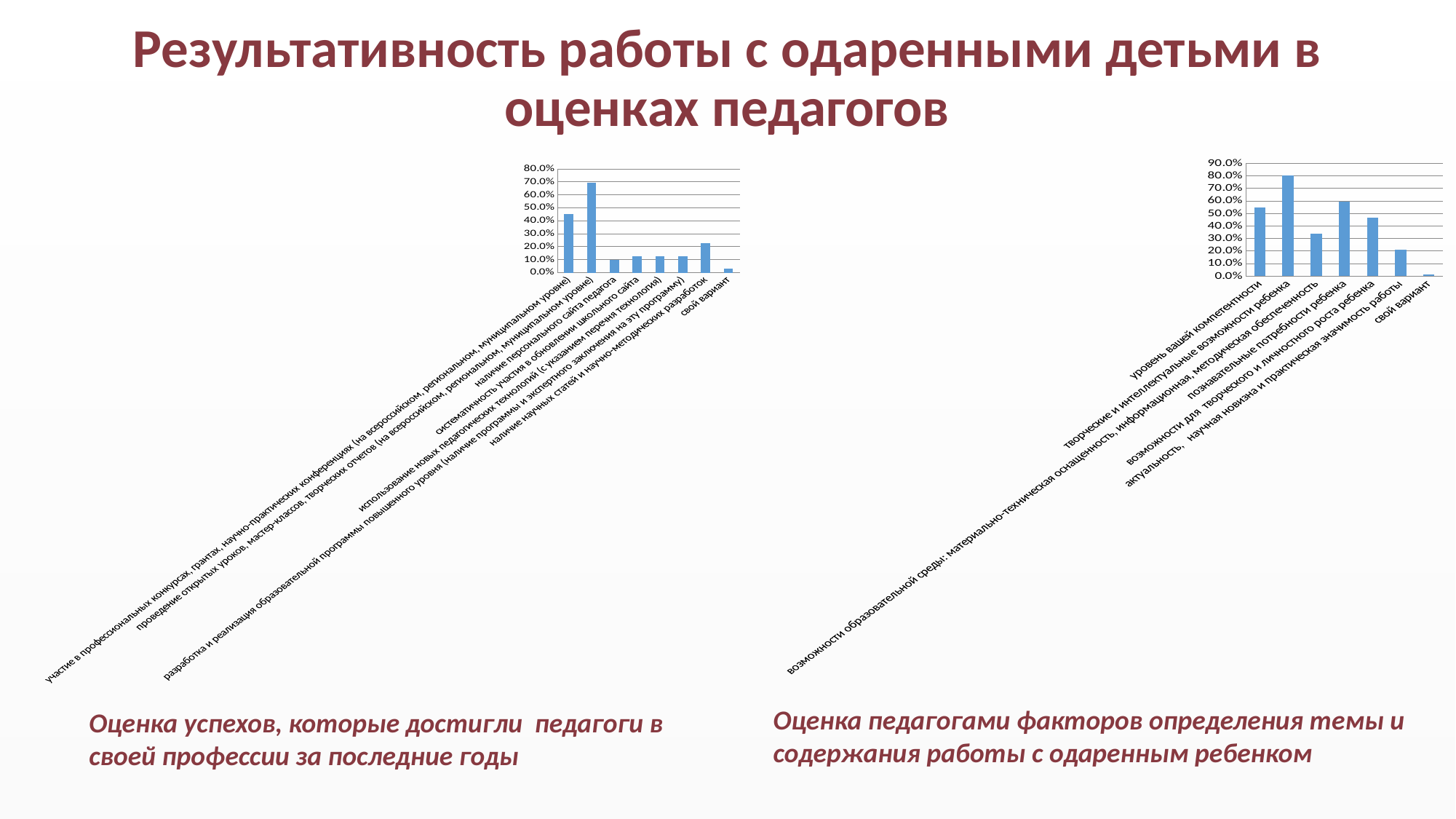
What kind of chart is the left chart on the slide? bar chart In the right chart, which is larger: the value for 'возможности для творческого и личностного роста ребенка' or the value for 'актуальность, научная новизна и практическая значимость работы'? возможности для творческого и личностного роста ребенка In the right chart, which category has the highest value? творческие и интеллектуальные возможности ребенка In the left chart, which category has the highest value? проведение открытых уроков, мастер-классов, творческих отчетов (на всероссийском, региональном, муниципальном уровне) In the left chart, which category has the lowest value? свой вариант In the right chart, is the value for 'познавательные потребности ребенка' greater or less than 40.0%? greater In the left chart, is the value for 'наличие научных статей и научно-методических разработок' greater or less than 30.0%? less How many categories does the left chart (Оценка успехов, которые достигли педагоги в своей профессии) show? 8 In the right chart, is the value for 'уровень вашей компетентности' greater or less than 50.0%? greater What is the highest tick value shown on the y axis of the right chart? 90.0% In the right chart, which category has the lowest value? свой вариант How many categories does the right chart (Оценка педагогами факторов определения темы и содержания работы) show? 7